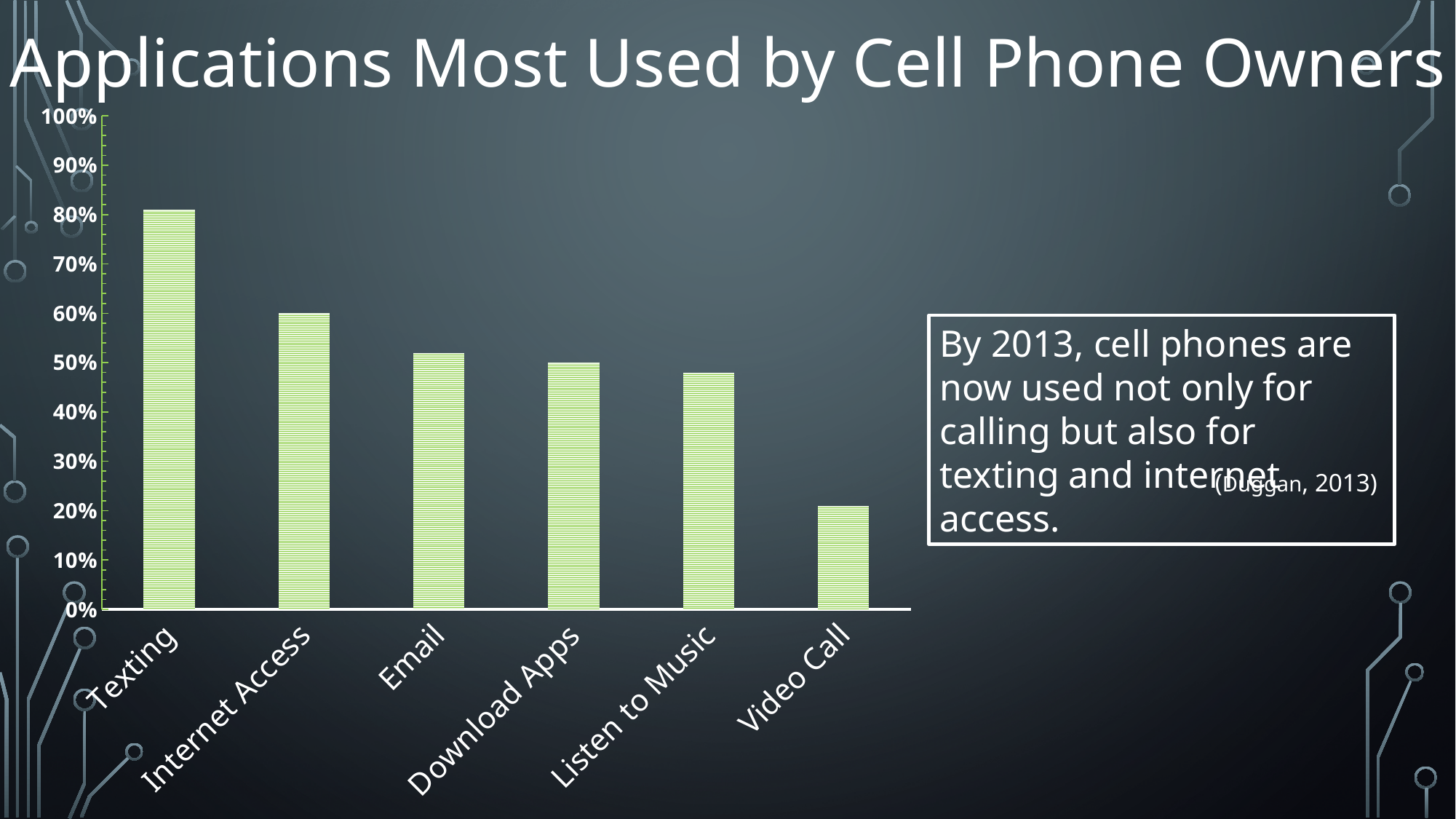
What kind of chart is shown on the slide? bar chart How many application categories are shown on the x axis? 6 Which application has the highest percentage of use? Texting Which is larger, the value for Internet Access or the value for Email? Internet Access Is the value for Video Call greater or less than 30%? less What is the title of the chart? Applications Most Used by Cell Phone Owners Which application has the lowest percentage of use? Video Call Which is larger, the value for Video Call or the value for Listen to Music? Listen to Music Is the value for Listen to Music greater or less than 40%? greater Do the values rise or fall moving from left to right along the x axis? fall Is the value for Email greater or less than 60%? less